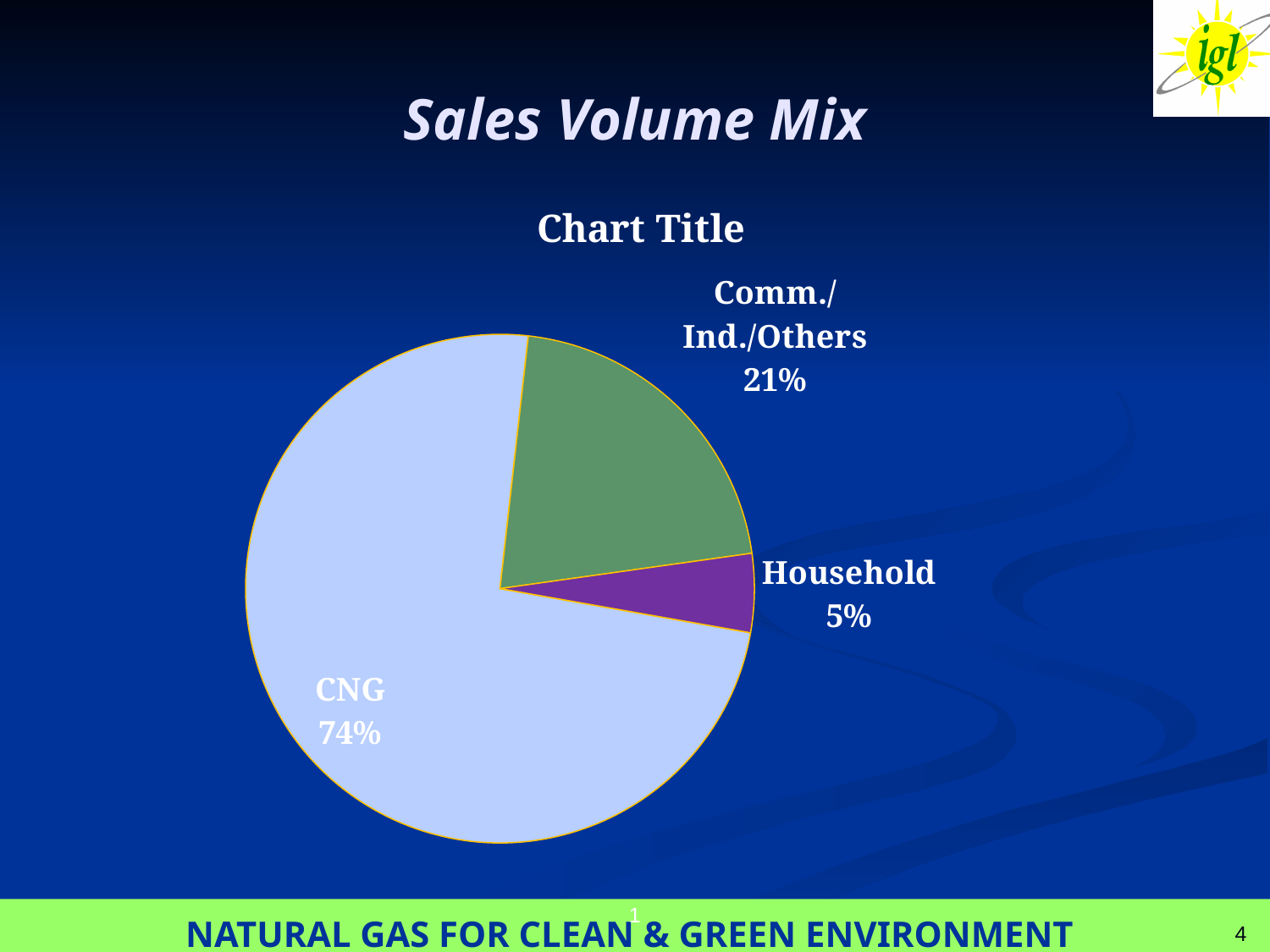
What is the value shown for Comm./Ind./Others? 21% Which is larger, the share for Comm./Ind./Others or the share for Household? Comm./Ind./Others What share of the pie does CNG account for? 74% What colour is the Household slice? purple Which category has the largest slice of the pie? CNG How many slices does the pie chart have? 3 What is the title printed above the pie chart? Chart Title What is the difference in percentage points between Comm./Ind./Others and Household? 16 What kind of chart is shown on the slide? pie chart What is the difference in percentage points between CNG and Comm./Ind./Others? 53 Which category has the smallest slice of the pie? Household What is the value shown for Household? 5%